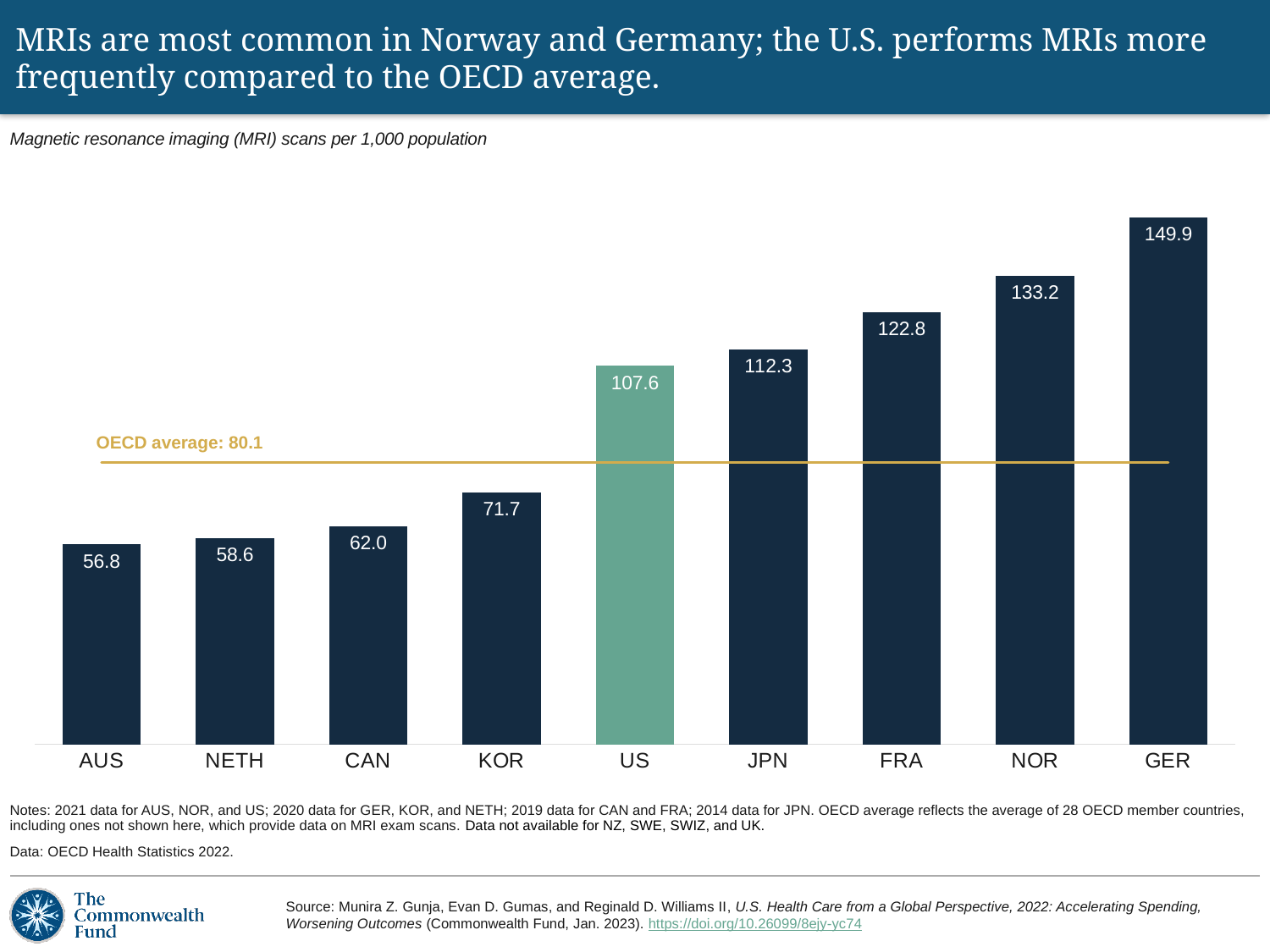
Which country has the lowest value? AUS Which country has the highest value? GER What is the value for KOR? 71.7 Do the values rise or fall from left to right across the x axis? Rise How many countries are shown in the chart? 9 Which is larger, the value for FRA or the value for JPN? FRA What is the value for NETH? 58.6 What is the value for US? 107.6 What kind of chart is this? Bar chart What is the difference between the values for GER and NOR? 16.7 What OECD average value is marked by the horizontal line on the chart? 80.1 What is the difference between the values for US and CAN? 45.6